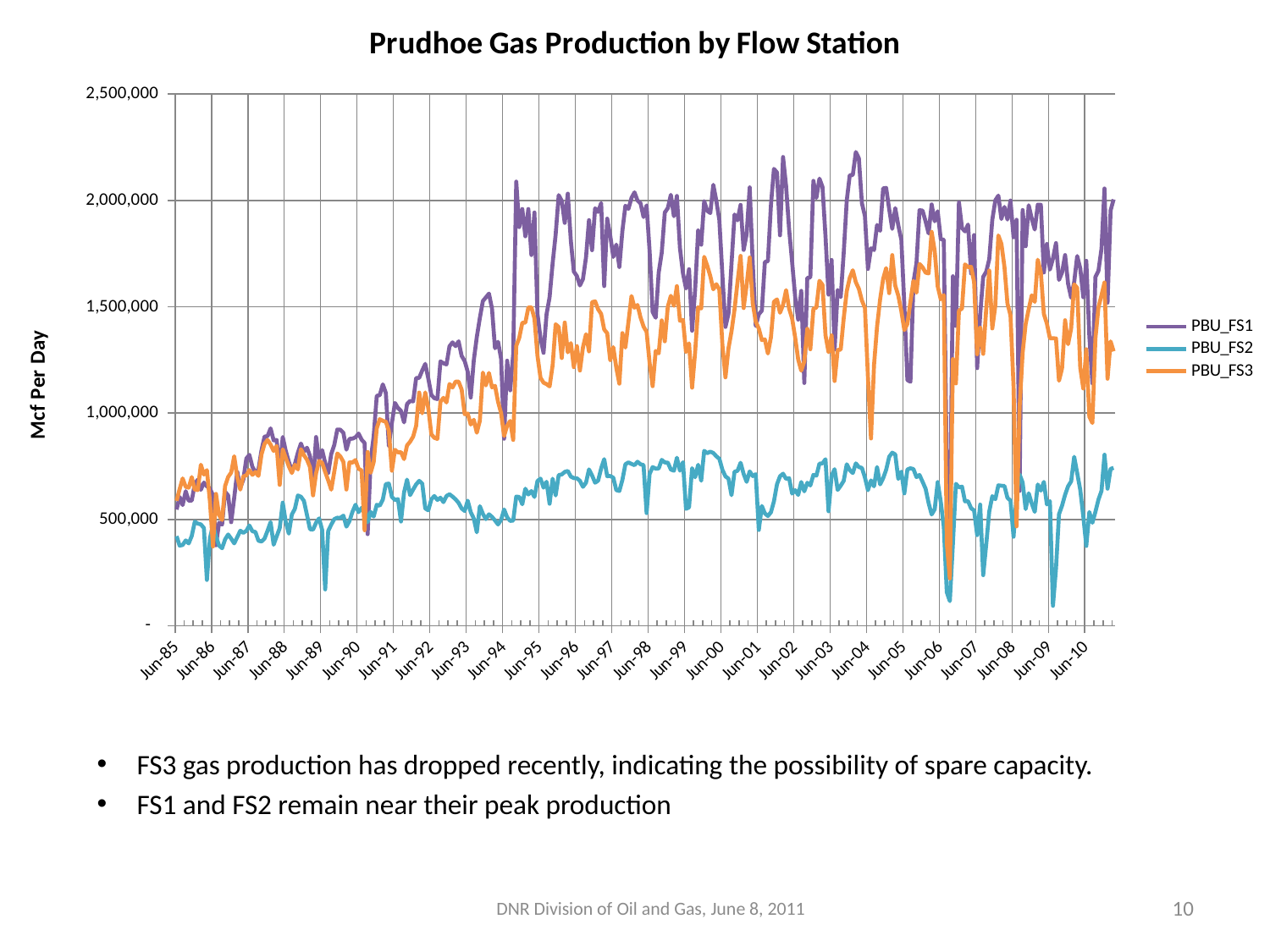
Which series has the highest values around Jun-00? PBU_FS1 Is the value for PBU_FS1 at Jun-85 greater or less than 1,000,000? less Is the value for PBU_FS2 at Jun-00 greater or less than 1,000,000? less Is the value for PBU_FS2 at Jun-85 greater or less than 500,000? less Which colour is used for the PBU_FS3 series? orange Which series has the lowest values across the whole chart? PBU_FS2 Does the PBU_FS1 series generally rise or fall from Jun-85 to Jun-95? rise What kind of chart is shown on the slide? line chart Which series is larger at Jun-95, PBU_FS1 or PBU_FS2? PBU_FS1 How many series does the legend list? 3 What is the title of the chart? Prudhoe Gas Production by Flow Station